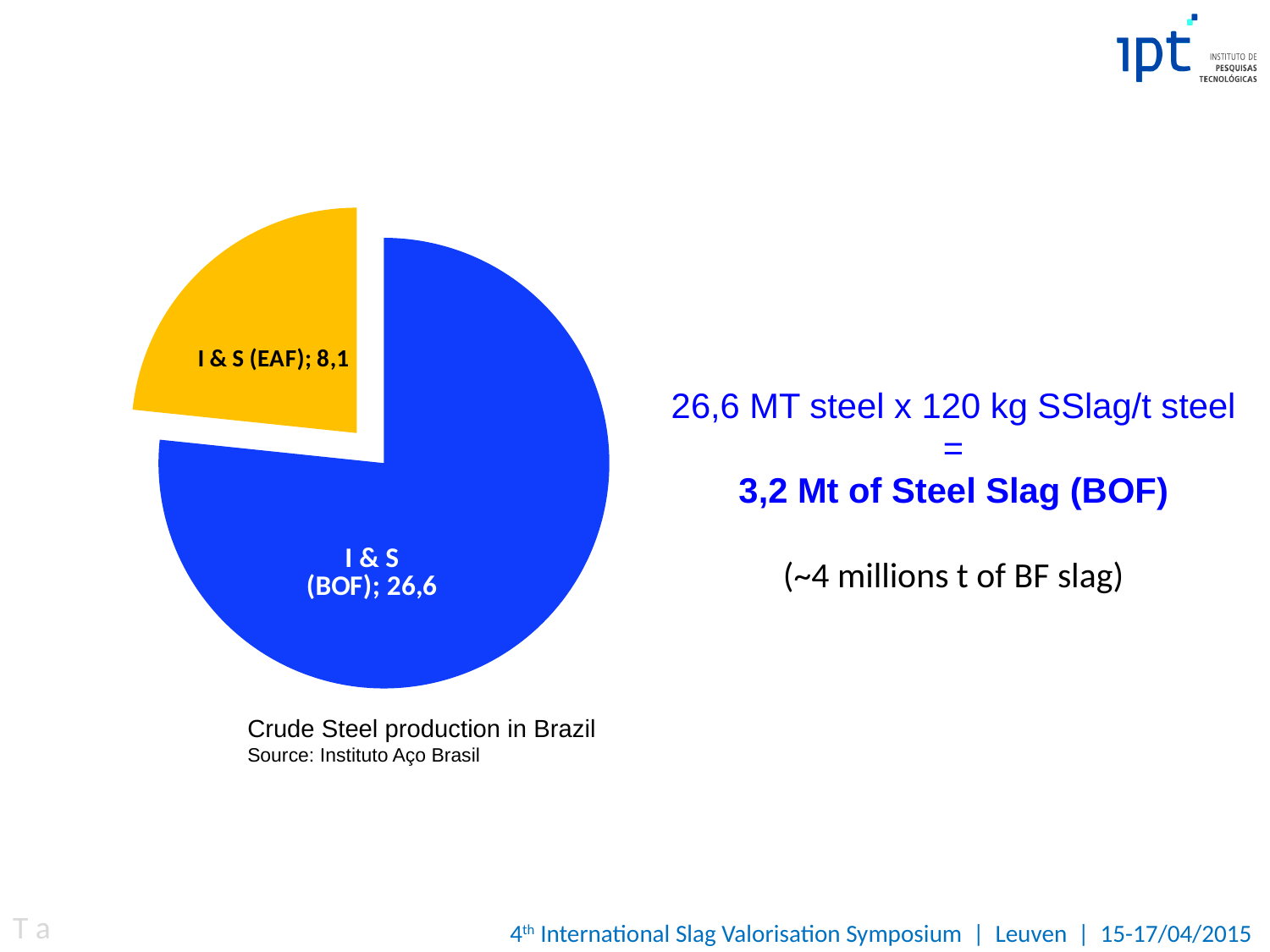
How many slices does the pie chart have? 2 What is the value shown for the I & S (EAF) slice? 8,1 What colour is the I & S (EAF) slice? yellow What is the total of the two values shown in the pie chart? 34,7 Which slice of the pie is the largest? I & S (BOF) What is the value shown for the I & S (BOF) slice? 26,6 What share of the pie does the I & S (BOF) slice represent, to one decimal place? 76,7% What is the difference between the I & S (BOF) value and the I & S (EAF) value? 18,5 Which is larger, the I & S (BOF) slice or the I & S (EAF) slice? I & S (BOF) Which slice of the pie is the smallest? I & S (EAF) What kind of chart is shown on the slide? pie chart What is the caption below the pie chart? Crude Steel production in Brazil